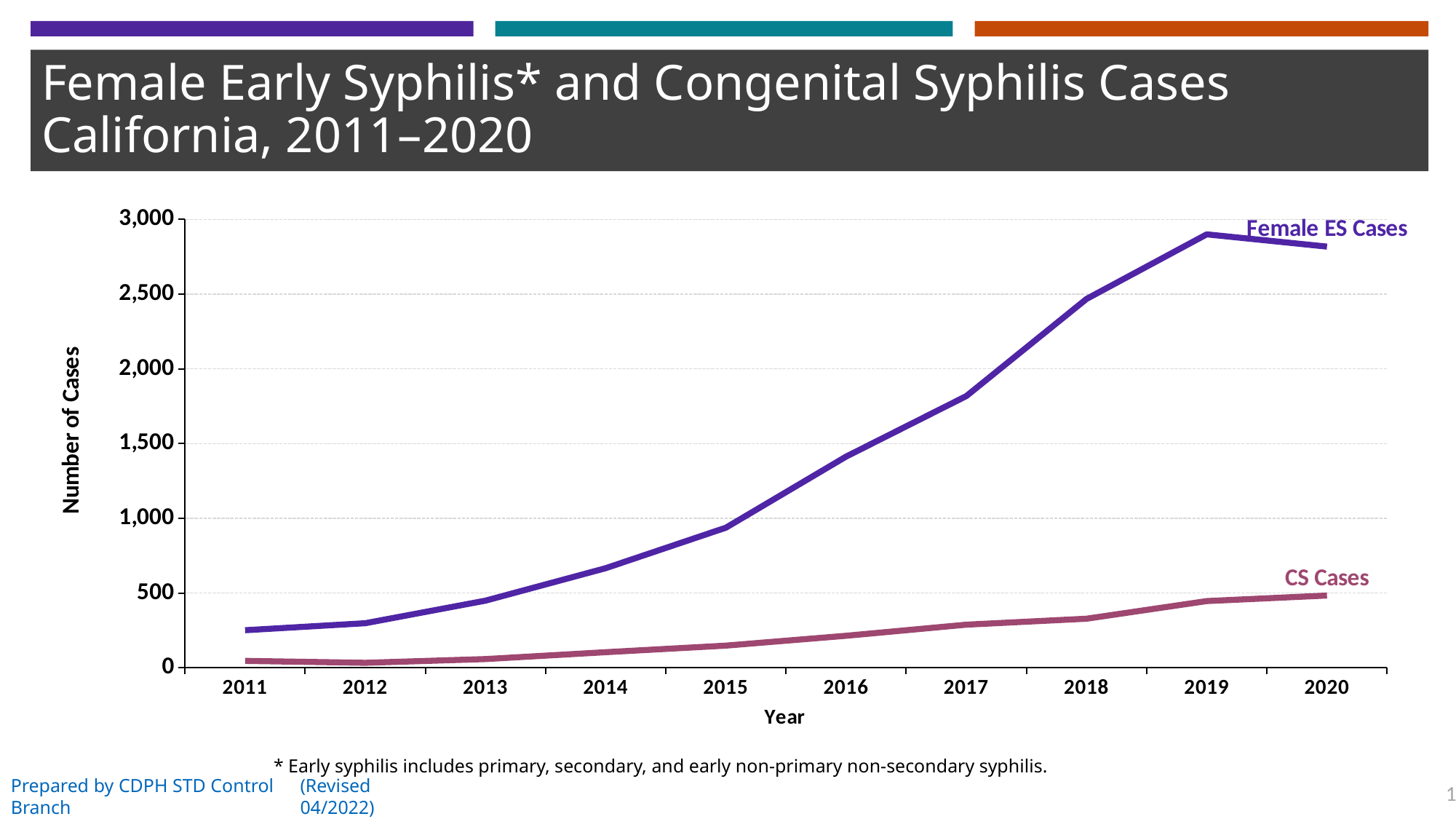
In which year are Female ES Cases lowest? 2011 How many data series are plotted on the chart? 2 Is the value for Female ES Cases in 2016 greater or less than 1,000? greater In which year do Female ES Cases reach their highest value? 2019 Do Female ES Cases rise or fall from 2011 to 2019? rise Is the value for Female ES Cases in 2019 greater or less than 2,500? greater What kind of chart is shown on the slide? line chart What is the title of the y axis? Number of Cases Is the value for Female ES Cases in 2015 greater or less than 1,000? less Which is larger: Female ES Cases in 2019 or Female ES Cases in 2020? 2019 How many years are shown along the x axis of the chart? 10